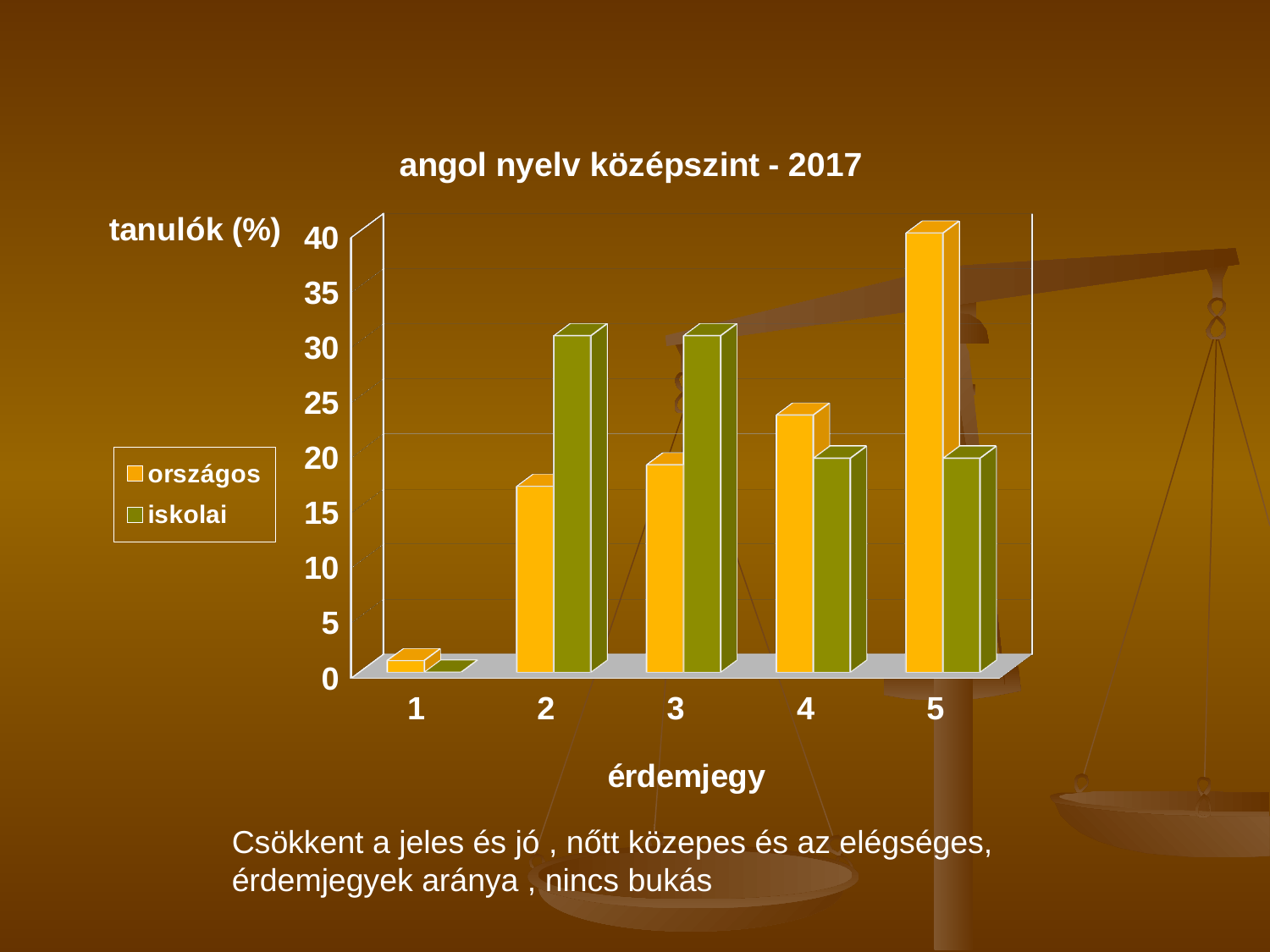
For érdemjegy 2, which series has the larger value, országos or iskolai? iskolai Which series is shown in green in the legend? iskolai Which érdemjegy has the highest országos value? 5 How many series does the legend list? 2 For érdemjegy 5, which series has the larger value, országos or iskolai? országos How many érdemjegy categories are shown on the x axis? 5 What is the title of the chart? angol nyelv középszint - 2017 Is the országos value for érdemjegy 5 greater or less than 35? greater Which érdemjegy has the lowest iskolai value? 1 What kind of chart is shown on the slide? bar chart Which érdemjegy has the lowest országos value? 1 Is the iskolai value for érdemjegy 2 greater or less than 25? greater